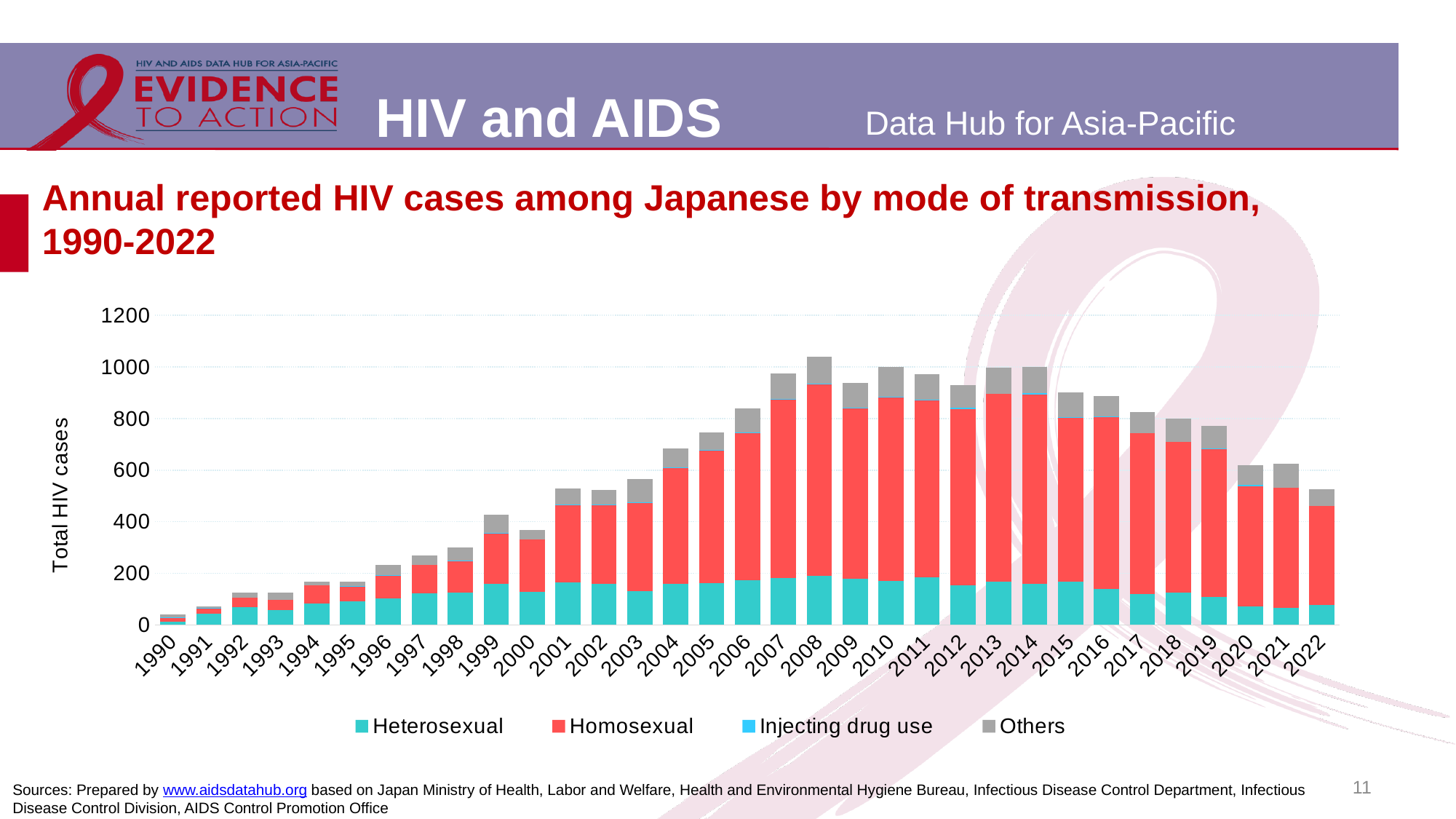
Which year has the lowest total of reported HIV cases? 1990 Is the total for 2008 greater or less than 1000? greater How many series does the legend list? 4 Is the total for 2022 greater or less than 600? less Which year has the highest total of reported HIV cases? 2008 Is the total for 1990 greater or less than 200? less What is the label on the y axis of the chart? Total HIV cases Do the total reported HIV cases rise or fall from 2014 to 2022? fall Which year has a larger total of reported HIV cases, 1999 or 2000? 1999 How many years are shown along the x axis? 33 What kind of chart is shown on the slide? Stacked bar chart